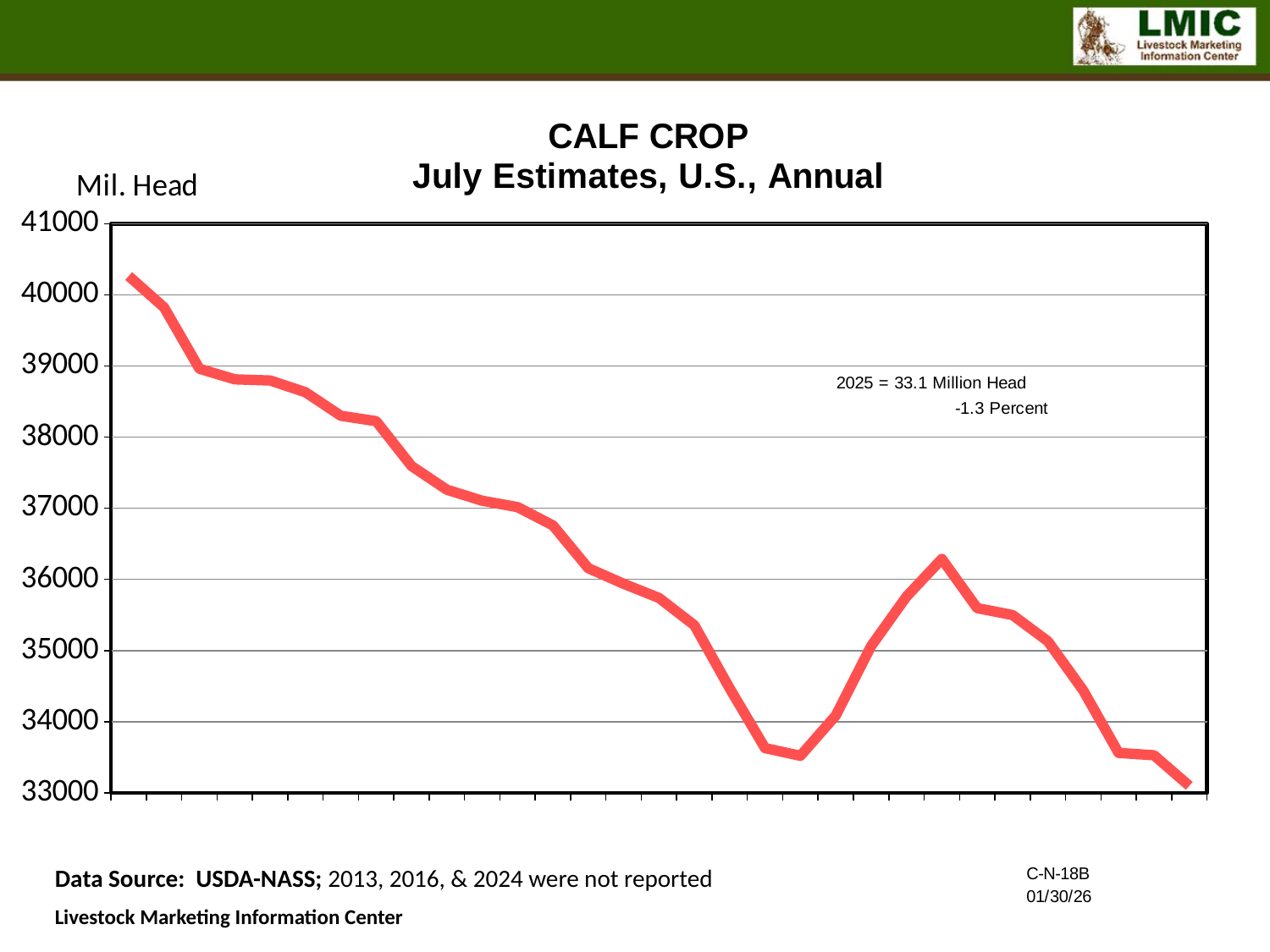
Is the value of the first (leftmost) point on the line greater or less than 40000? greater Is the value at the local peak in the right half of the chart greater or less than 36000? greater Is the value of the last (rightmost) point on the line greater or less than 34000? less What kind of chart is shown on the slide? line chart Where on the line does the highest value occur? at the first (leftmost) point Overall, do the calf crop values rise or fall from left to right along the x axis? fall Which is larger, the value at the first point on the line or the value at the last point? the first point What unit label is shown above the y axis? Mil. Head According to the annotation on the chart, what was the percent change in the calf crop for 2025? -1.3 Percent What is the title of the chart? CALF CROP July Estimates, U.S., Annual According to the annotation on the chart, what was the U.S. calf crop in 2025? 33.1 Million Head Where on the line does the lowest value occur? at the last (rightmost) point